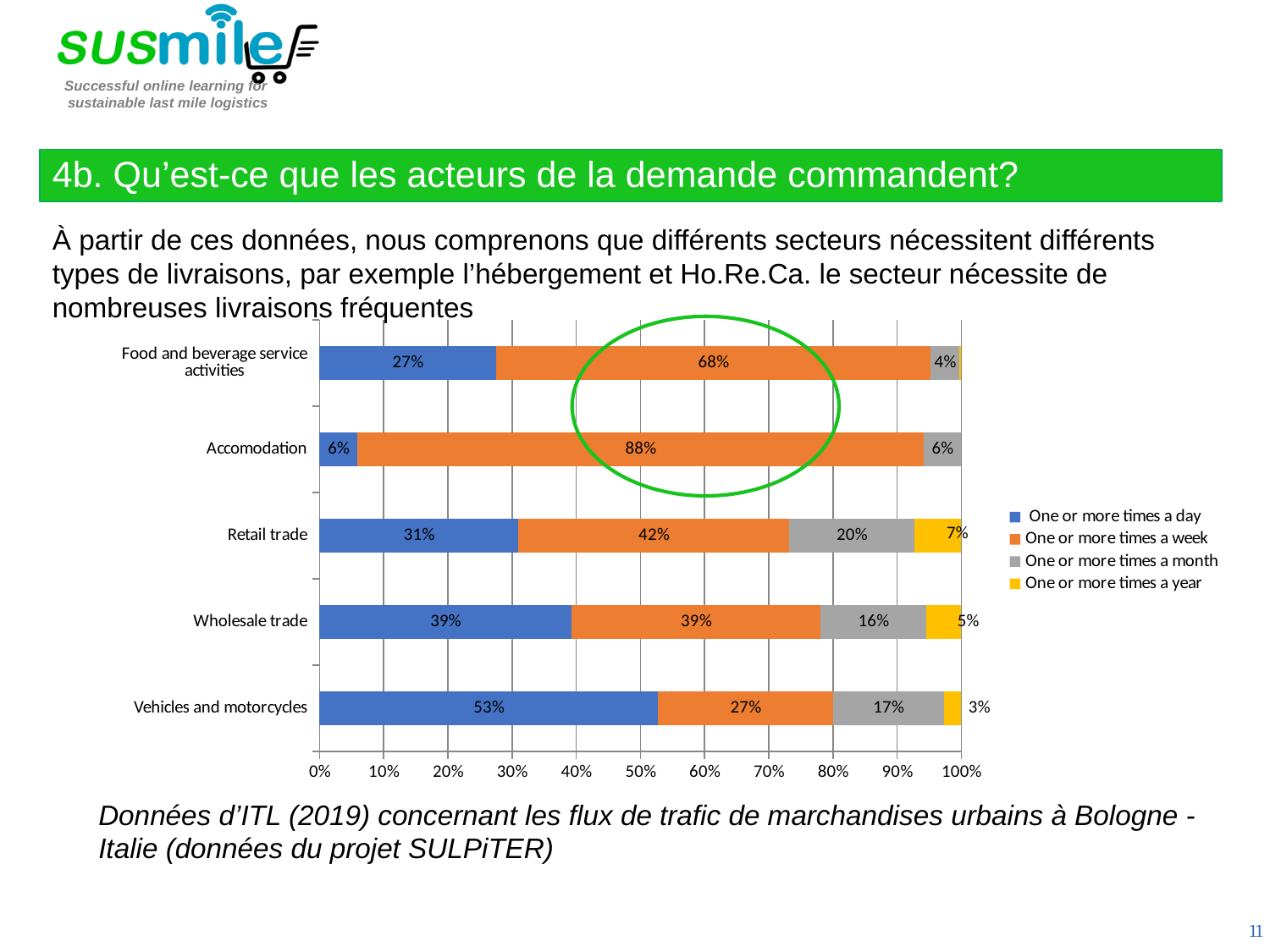
What is the 'One or more times a month' value for Retail trade? 20% Which has a larger 'One or more times a day' share: Wholesale trade or Food and beverage service activities? Wholesale trade What percentage of Accomodation deliveries are 'One or more times a week'? 88% Which category has the lowest 'One or more times a day' share? Accomodation How many series does the legend list? 4 Which category has the highest 'One or more times a day' share? Vehicles and motorcycles What is the 'One or more times a day' value for Vehicles and motorcycles? 53% How many sector categories are shown on the chart? 5 What is the 'One or more times a year' value for Wholesale trade? 5% What colour represents 'One or more times a week' in the chart? Orange What type of chart is shown on the slide? Stacked bar chart For Retail trade, how much larger is the 'One or more times a week' share than the 'One or more times a day' share? 11 percentage points